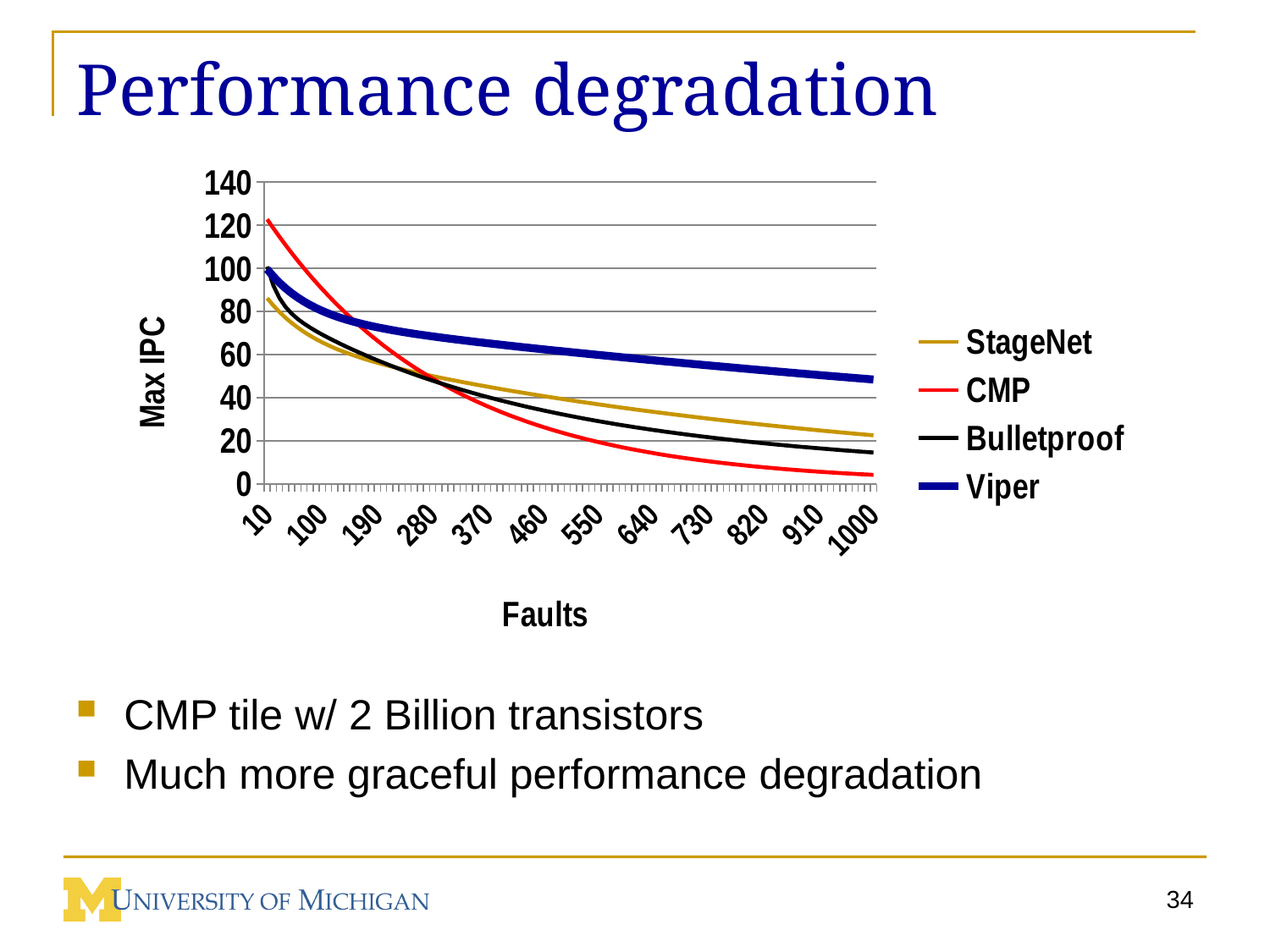
Which series has the highest Max IPC at 1000 faults? Viper Is the Max IPC for CMP at 1000 faults greater or less than 20? less What is the label on the vertical axis of the chart? Max IPC What kind of chart is shown on the slide? line chart At 10 faults, which is larger: the Max IPC for CMP or for Viper? CMP Does the Max IPC for Viper rise or fall as the number of faults increases? fall Which series has the lowest Max IPC at 1000 faults? CMP Is the Max IPC for CMP at 10 faults greater or less than 100? greater Which series has the highest Max IPC at 10 faults? CMP At 1000 faults, which is larger: the Max IPC for Viper or for StageNet? Viper Is the Max IPC for Viper at 1000 faults greater or less than 60? less How many series does the legend list? 4